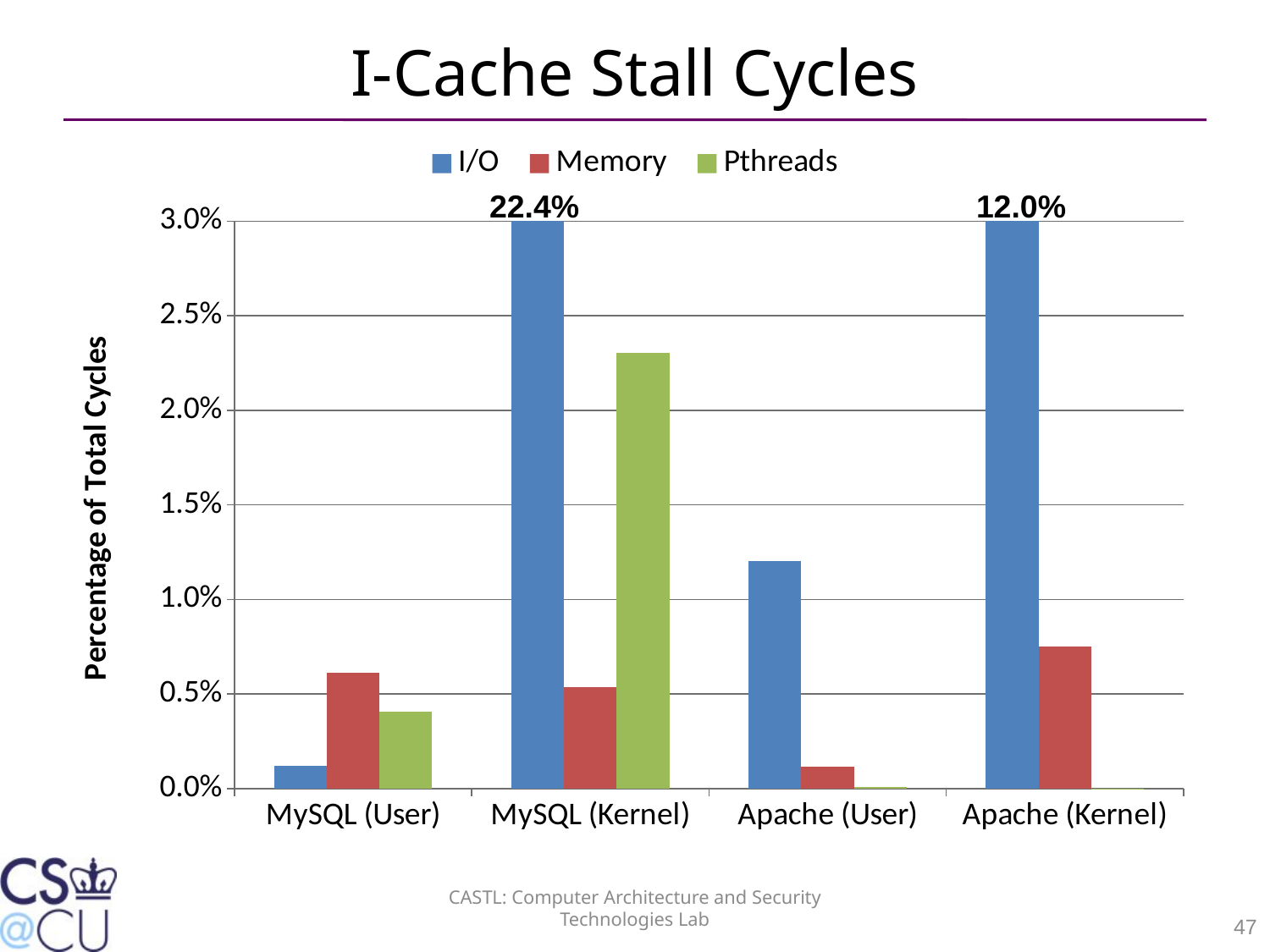
How many categories are shown on the x axis? 4 How many series does the legend list? 3 Is the I/O value for Apache (User) greater or less than 1.0%? greater What is the I/O value for MySQL (Kernel)? 22.4% Is the Pthreads value for MySQL (Kernel) greater or less than 2.0%? greater What is the I/O value for Apache (Kernel)? 12.0% Which category has the highest I/O value? MySQL (Kernel) What type of chart is shown on the slide? bar chart Which category has the lowest Memory value? Apache (User) What is the label of the y axis? Percentage of Total Cycles What is the difference between the I/O values for MySQL (Kernel) and Apache (Kernel)? 10.4% Which is larger, the I/O value for MySQL (Kernel) or for Apache (Kernel)? MySQL (Kernel)